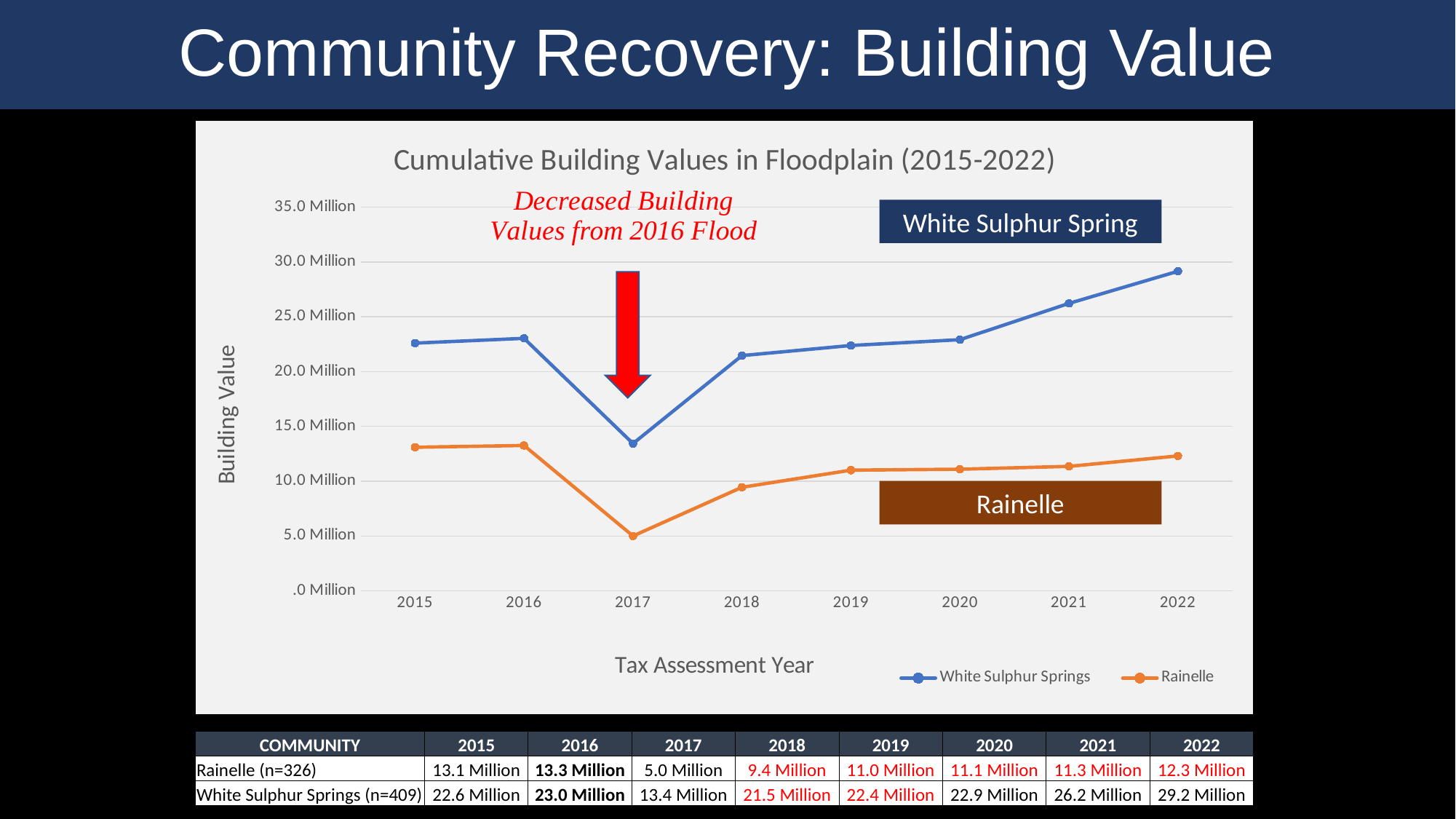
What is the building value for Rainelle in 2022? 12.3 Million Is the White Sulphur Springs building value in 2021 greater or less than 25.0 Million? greater What is the title of the chart? Cumulative Building Values in Floodplain (2015-2022) What type of chart is shown on the slide? line chart In which year is the White Sulphur Springs building value lowest? 2017 Which series has the larger building value in 2019, White Sulphur Springs or Rainelle? White Sulphur Springs How many years are plotted along the x axis? 8 What is the difference between the White Sulphur Springs and Rainelle building values in 2022? 16.9 Million In which year is the Rainelle building value highest? 2016 What is the building value for White Sulphur Springs in 2017? 13.4 Million How many series does the legend list? 2 Does the Rainelle building value rise or fall from 2017 to 2022? rise